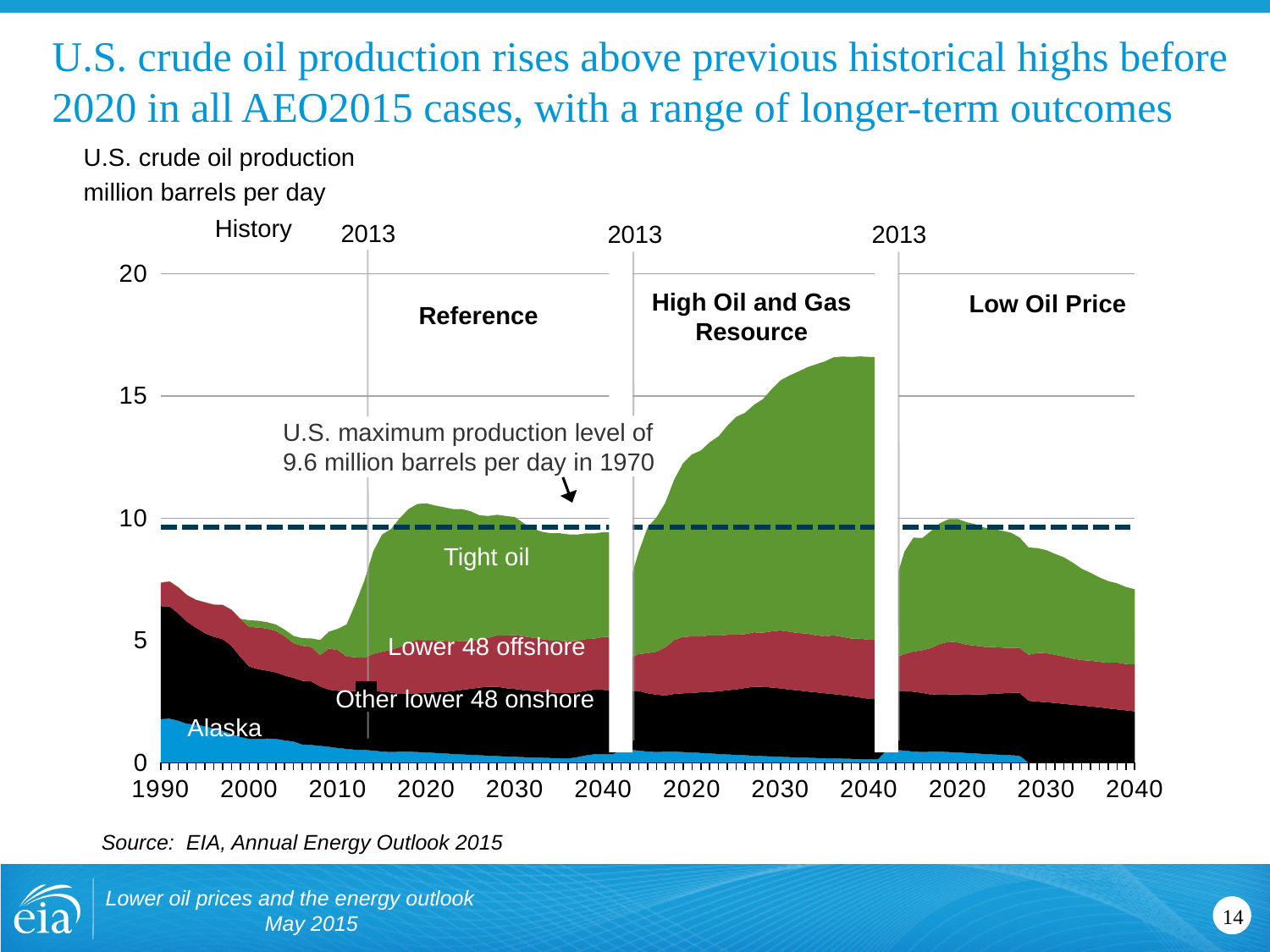
In the High Oil and Gas Resource case, is total production in 2040 greater or less than 15 million barrels per day? greater Is Alaska production larger in 1990 or in 2013? 1990 In the Low Oil Price case, does total production rise or fall from 2020 to 2040? falls How many AEO2015 projection cases are shown in the chart? 3 What was the U.S. maximum production level in 1970, as marked by the dashed line? 9.6 million barrels per day What unit is used on the chart's vertical axis? million barrels per day In the High Oil and Gas Resource case, does total production rise or fall from 2013 to 2040? rises In the Low Oil Price case, is total production in 2040 greater or less than 10 million barrels per day? less Which projection case shows the highest total crude oil production in 2040? High Oil and Gas Resource What kind of chart is shown on the slide? Stacked area chart How many production categories (areas) are labeled in the chart? 4 Which projection case shows the lowest total crude oil production in 2040? Low Oil Price